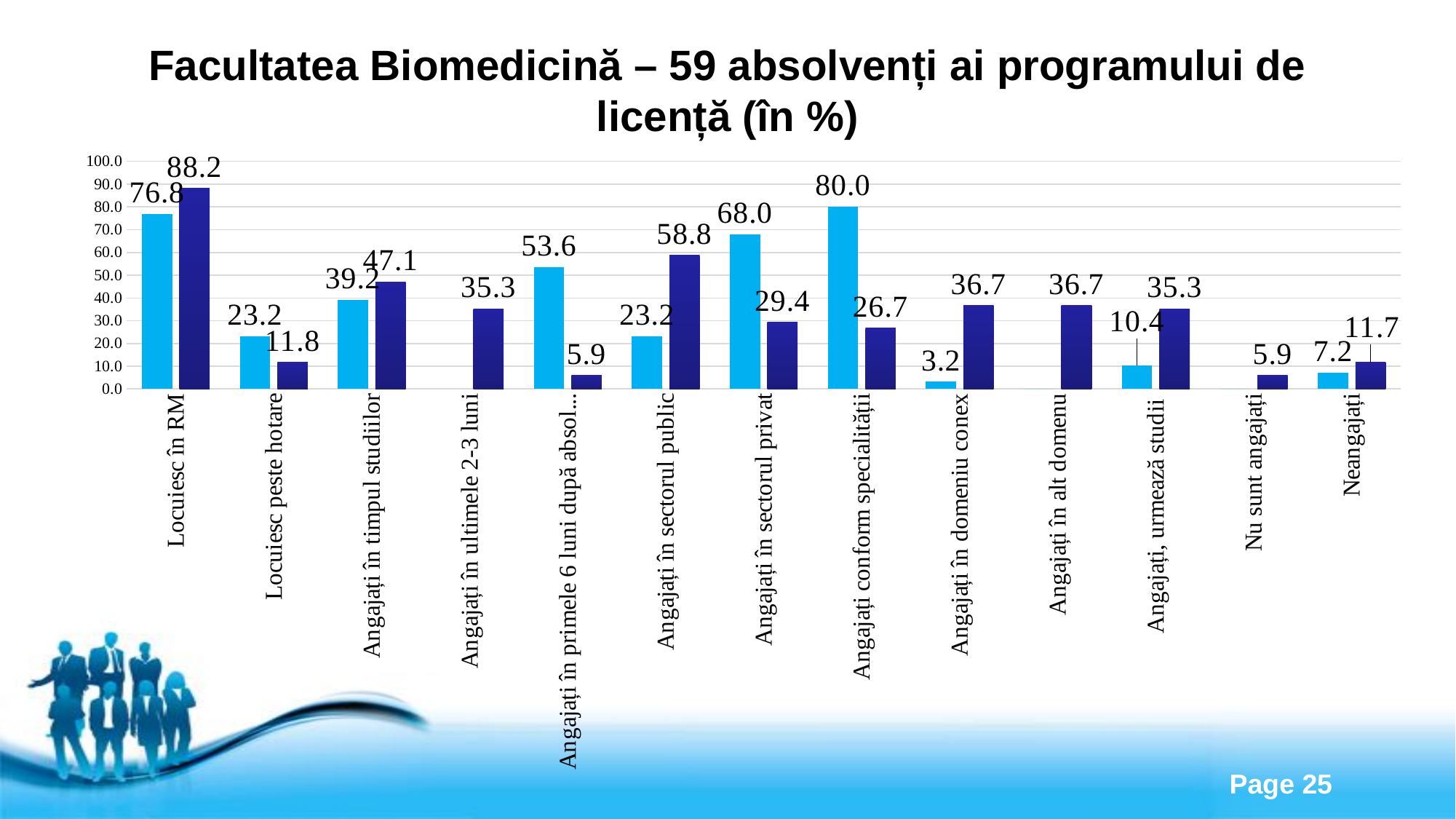
What is the value of the dark blue bar for "Angajați în sectorul public"? 58.8 What is the title of the chart on the slide? Facultatea Biomedicină – 59 absolvenți ai programului de licență (în %) For "Angajați în primele 6 luni după absol...", which bar is larger, the light blue or the dark blue? light blue Which category has the lowest light blue bar among those with a light blue value label? Angajați în domeniu conex What is the value of the light blue bar for "Angajați conform specialității"? 80.0 What type of chart is shown on the slide? bar chart How many categories are shown on the x axis of the chart? 13 Which category has the highest dark blue bar? Locuiesc în RM What is the value of the dark blue bar for "Locuiesc în RM"? 88.2 What is the value of the light blue bar for "Angajați în sectorul privat"? 68.0 Is the value of the light blue bar for "Angajați în timpul studiilor" greater or less than 50.0? less What is the difference between the dark blue and light blue bars for "Locuiesc în RM"? 11.4